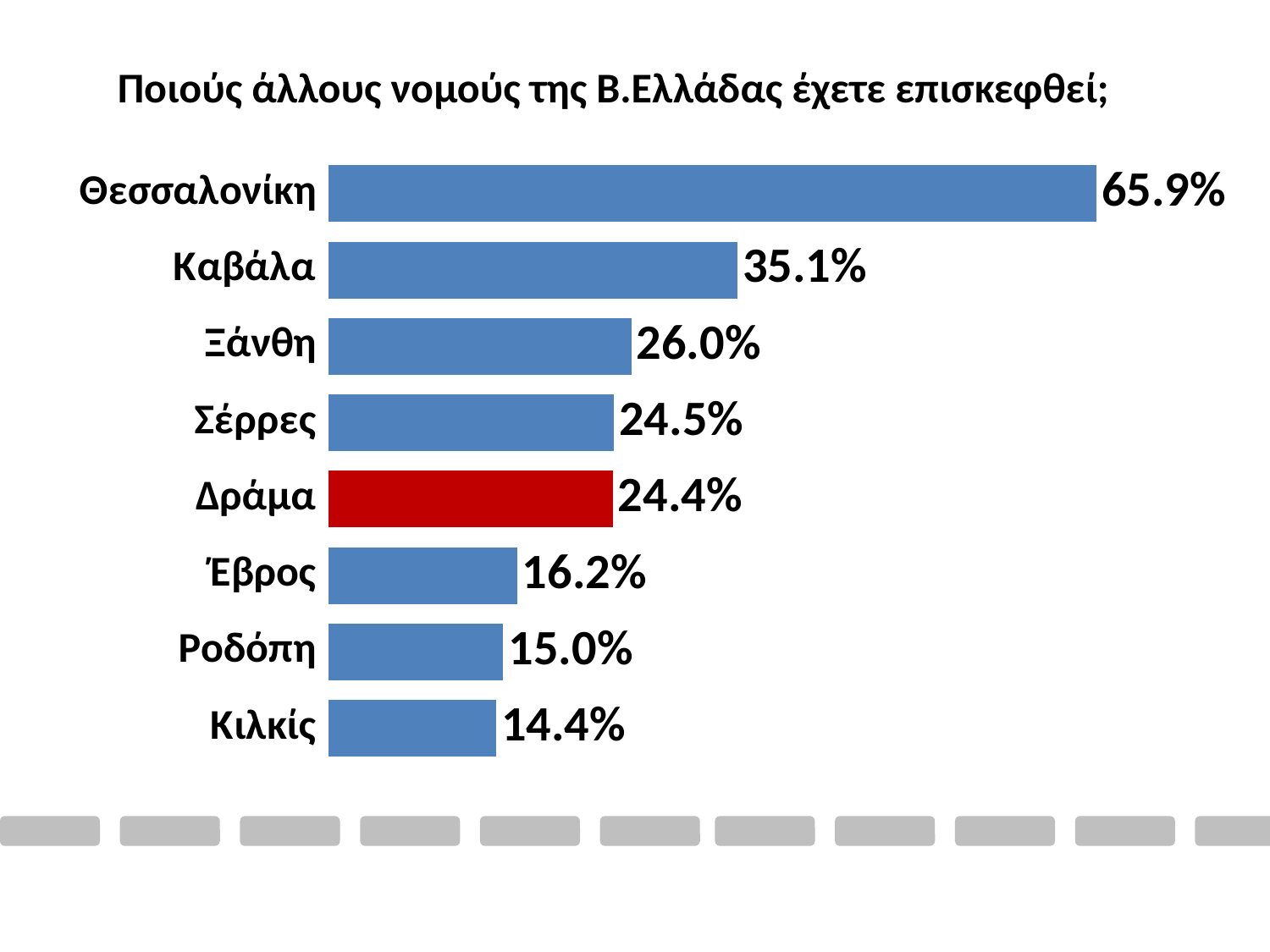
Which category has the highest value? Θεσσαλονίκη What is the value for Ροδόπη? 15.0% How many categories are shown in the chart? 8 Which bar is coloured red rather than blue? Δράμα What is the difference between the values for Έβρος and Κιλκίς? 1.8% What is the value for Δράμα? 24.4% What is the title of the chart? Ποιούς άλλους νομούς της Β.Ελλάδας έχετε επισκεφθεί; What kind of chart is shown on the slide? Bar chart What is the value for Θεσσαλονίκη? 65.9% Which category has the lowest value? Κιλκίς What is the difference between the values for Θεσσαλονίκη and Καβάλα? 30.8% Which is larger, the value for Καβάλα or the value for Ξάνθη? Καβάλα